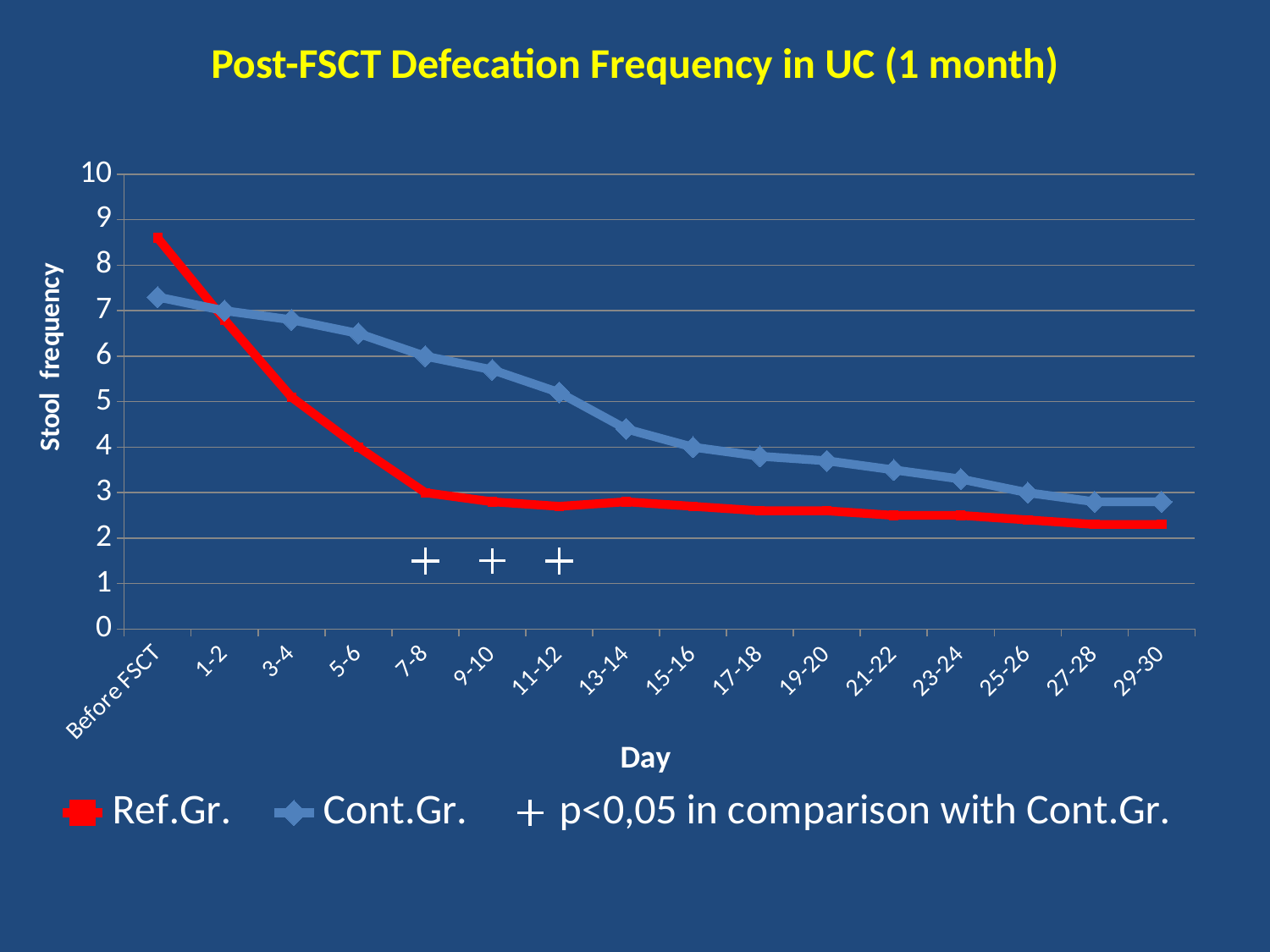
What kind of chart is shown on the slide? line chart Is the value for Ref.Gr. at Before FSCT greater or less than 8? greater At which x-axis category is the Ref.Gr. value highest? Before FSCT At day 7-8, which series has the higher stool frequency, Ref.Gr. or Cont.Gr.? Cont.Gr. Is the value for Ref.Gr. at day 29-30 greater or less than 3? less At Before FSCT, which series has the higher stool frequency, Ref.Gr. or Cont.Gr.? Ref.Gr. Is the value for Cont.Gr. at Before FSCT greater or less than 7? greater Do the Ref.Gr. values rise or fall from Before FSCT to day 29-30? fall How many entries does the legend list? 3 How many categories are shown on the x axis (Day)? 16